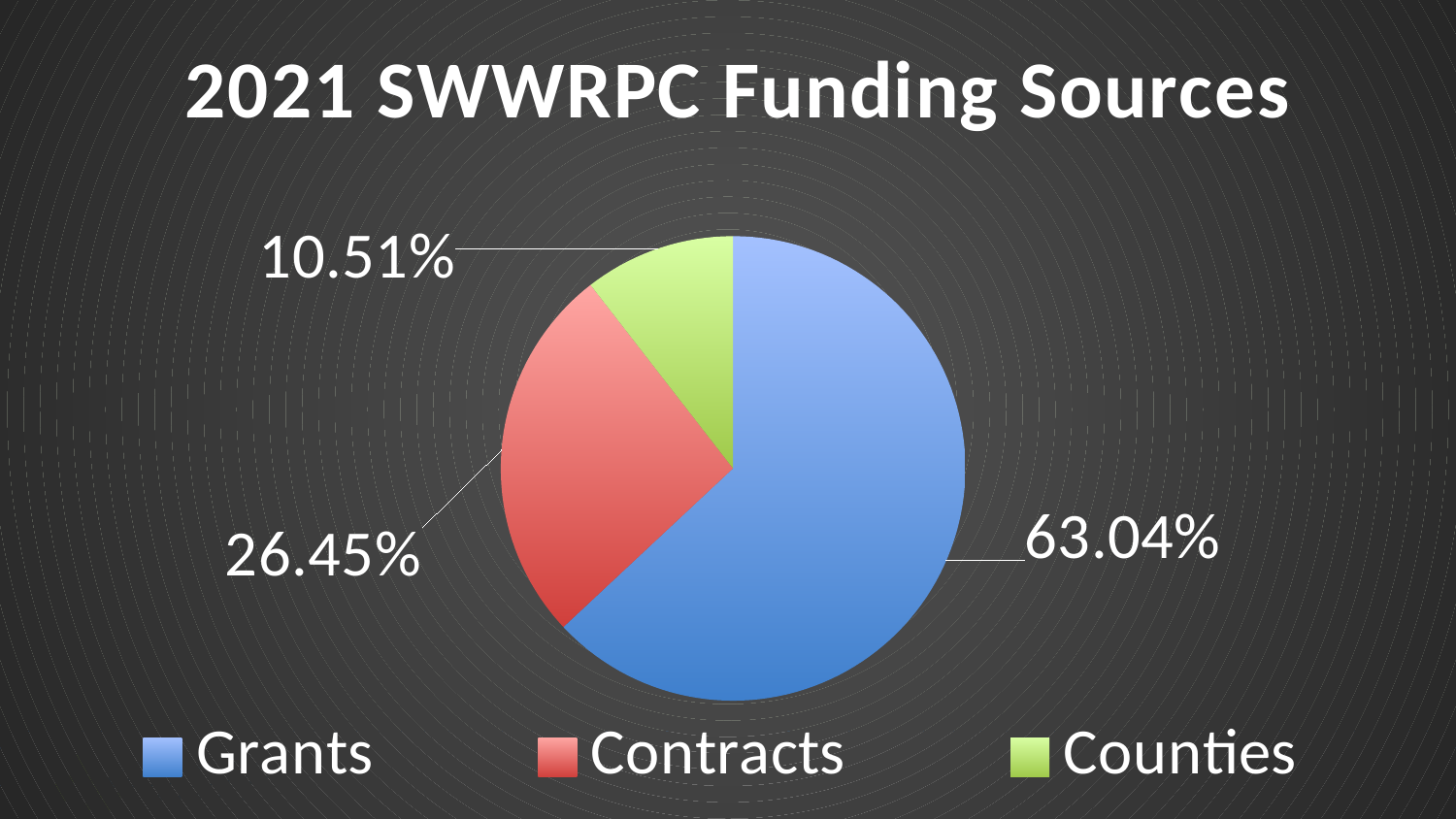
What share of 2021 SWWRPC funding comes from Counties? 10.51% What is the title of the chart? 2021 SWWRPC Funding Sources What is the combined share of Contracts and Counties? 36.96% What is the difference in percentage points between the Grants share and the Contracts share? 36.59 Which funding source has the largest share of the pie? Grants Which funding source has the smallest share of the pie? Counties What share of 2021 SWWRPC funding comes from Contracts? 26.45% What share of 2021 SWWRPC funding comes from Grants? 63.04% Which colour represents Contracts in the pie chart? Red What kind of chart is shown on the slide? Pie chart Which is larger, the Contracts share or the Counties share? Contracts How many funding sources are shown in the pie chart? 3